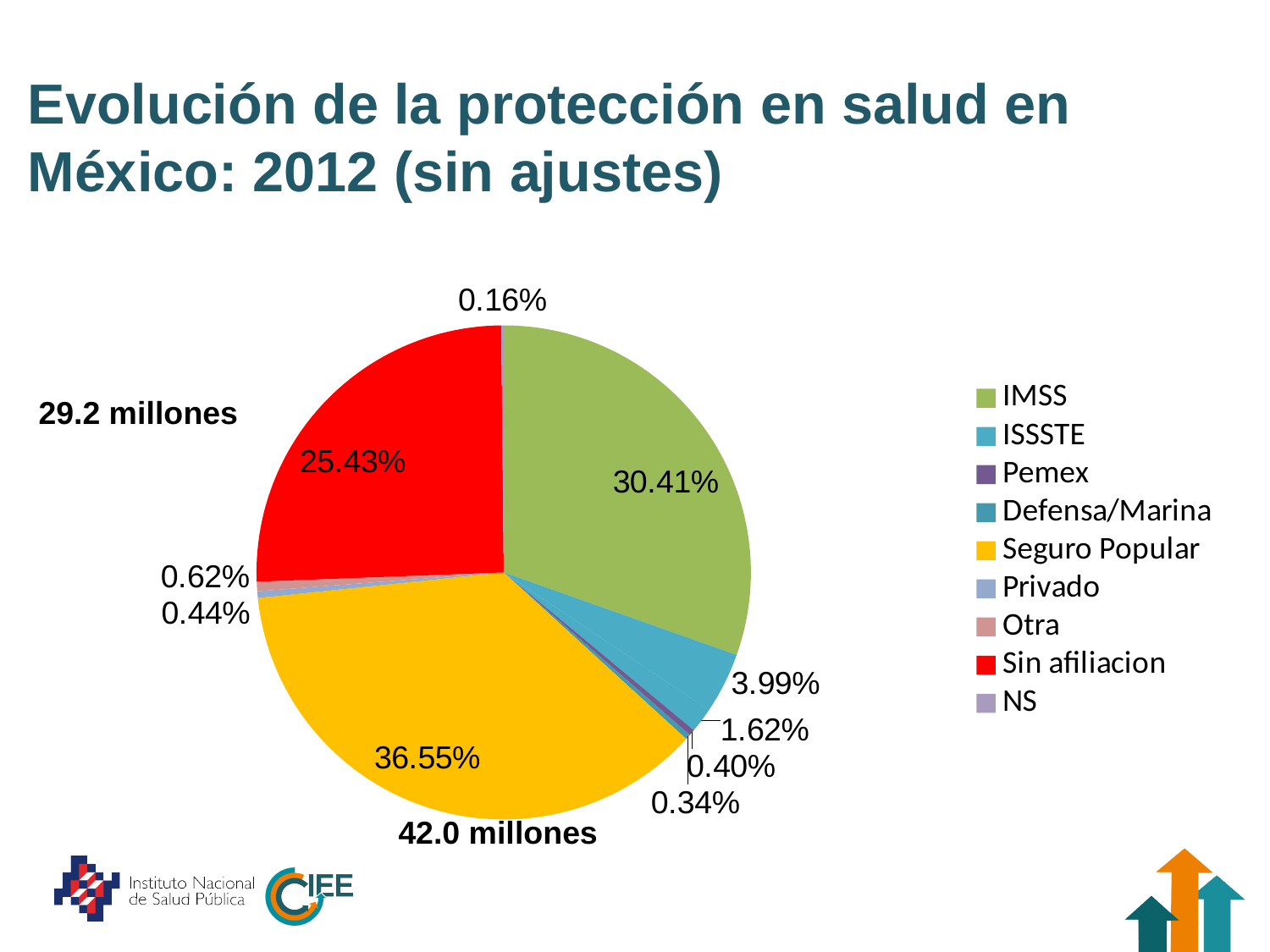
By how many percentage points does Seguro Popular exceed IMSS? 6.14 What percentage is shown for Sin afiliacion? 25.43% What type of chart is shown on the slide? pie chart What percentage is shown for Seguro Popular? 36.55% Which is larger, the share for IMSS or the share for Sin afiliacion? IMSS What is the smallest percentage label shown on the pie? 0.16% How many entries does the legend list? 9 What percentage of the pie does IMSS account for? 30.41% What percentage is shown for ISSSTE? 3.99% What number of people in millions is annotated next to the Seguro Popular slice? 42.0 millones By how many percentage points does IMSS exceed Sin afiliacion? 4.98 Which category has the largest share of the pie? Seguro Popular